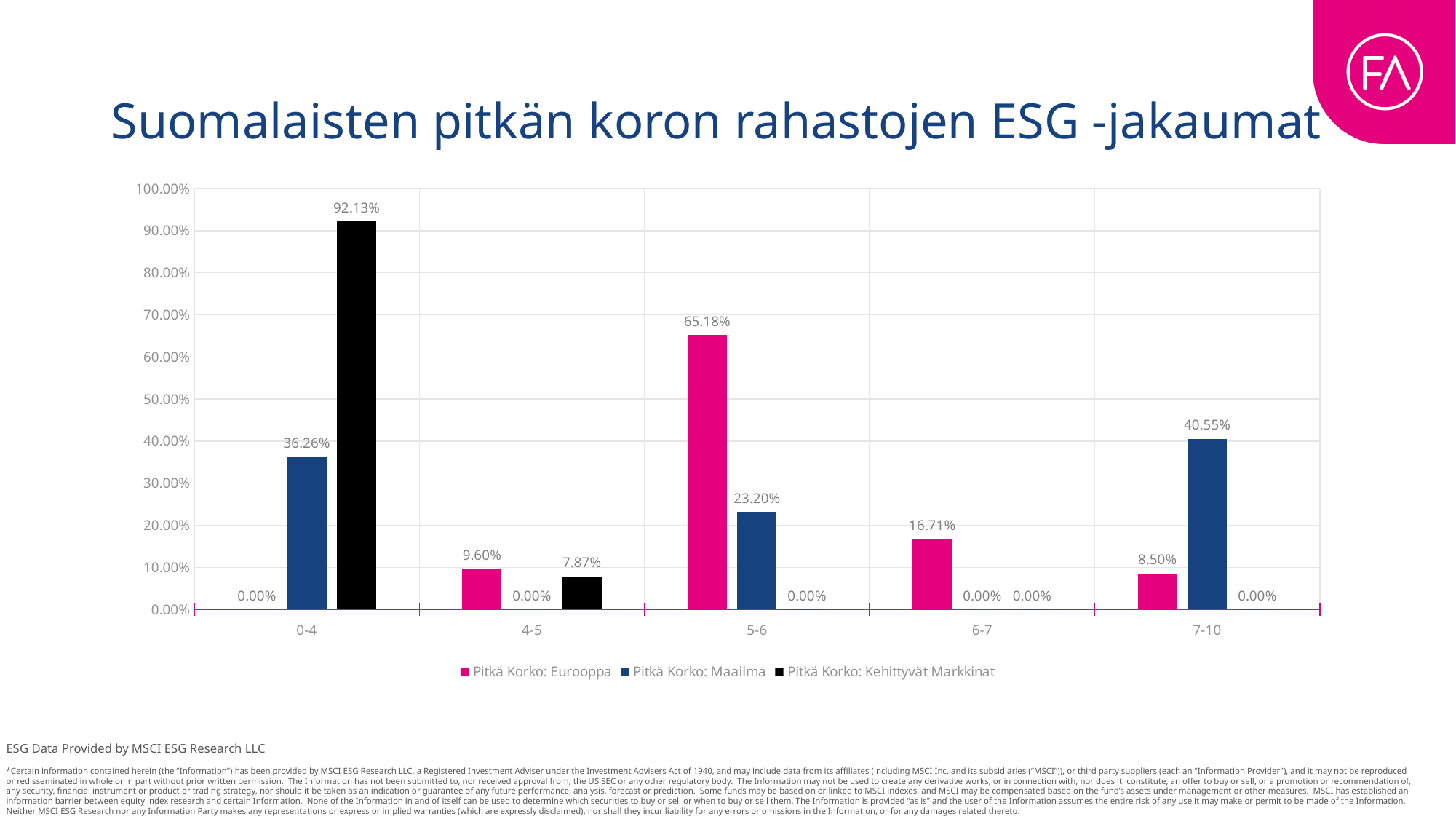
Which category has the highest value for Pitkä Korko: Maailma? 7-10 What is the value for Pitkä Korko: Maailma in the 7-10 category? 40.55% What is the value for Pitkä Korko: Kehittyvät Markkinat in the 0-4 category? 92.13% In the 4-5 category, which is larger: Pitkä Korko: Eurooppa or Pitkä Korko: Kehittyvät Markkinat? Pitkä Korko: Eurooppa Is the value for Pitkä Korko: Maailma in the 5-6 category greater or less than 30.00%? less Which category has the highest value for Pitkä Korko: Eurooppa? 5-6 How many series does the legend list? 3 How many categories are shown on the x axis? 5 What kind of chart is shown on the slide? Bar chart What is the value for Pitkä Korko: Eurooppa in the 6-7 category? 16.71% What is the value for Pitkä Korko: Eurooppa in the 5-6 category? 65.18% What is the difference between Pitkä Korko: Kehittyvät Markkinat and Pitkä Korko: Maailma in the 0-4 category? 55.87%